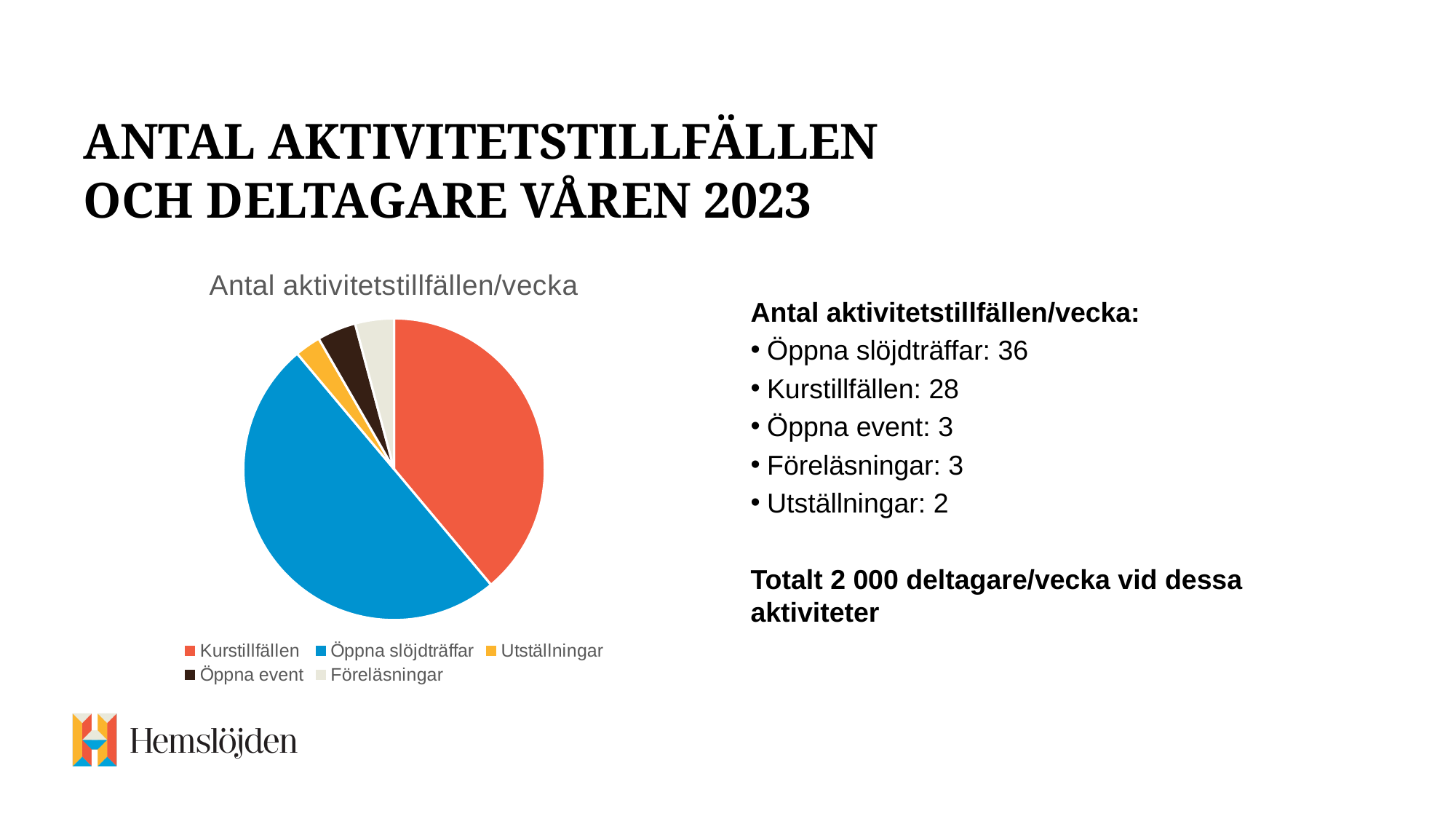
What is the value for Öppna slöjdträffar? 36 What is the value for Föreläsningar? 3 What type of chart is shown on the slide? pie chart What is the value for Utställningar? 2 How many categories does the pie chart have? 5 Which is larger, Kurstillfällen or Öppna event? Kurstillfällen What is the difference between the values for Öppna slöjdträffar and Kurstillfällen? 8 What is the value for Kurstillfällen? 28 What share of the pie does Öppna slöjdträffar represent? 50% Which category has the smallest slice of the pie? Utställningar What is the title of the chart? Antal aktivitetstillfällen/vecka Which category has the largest slice of the pie? Öppna slöjdträffar